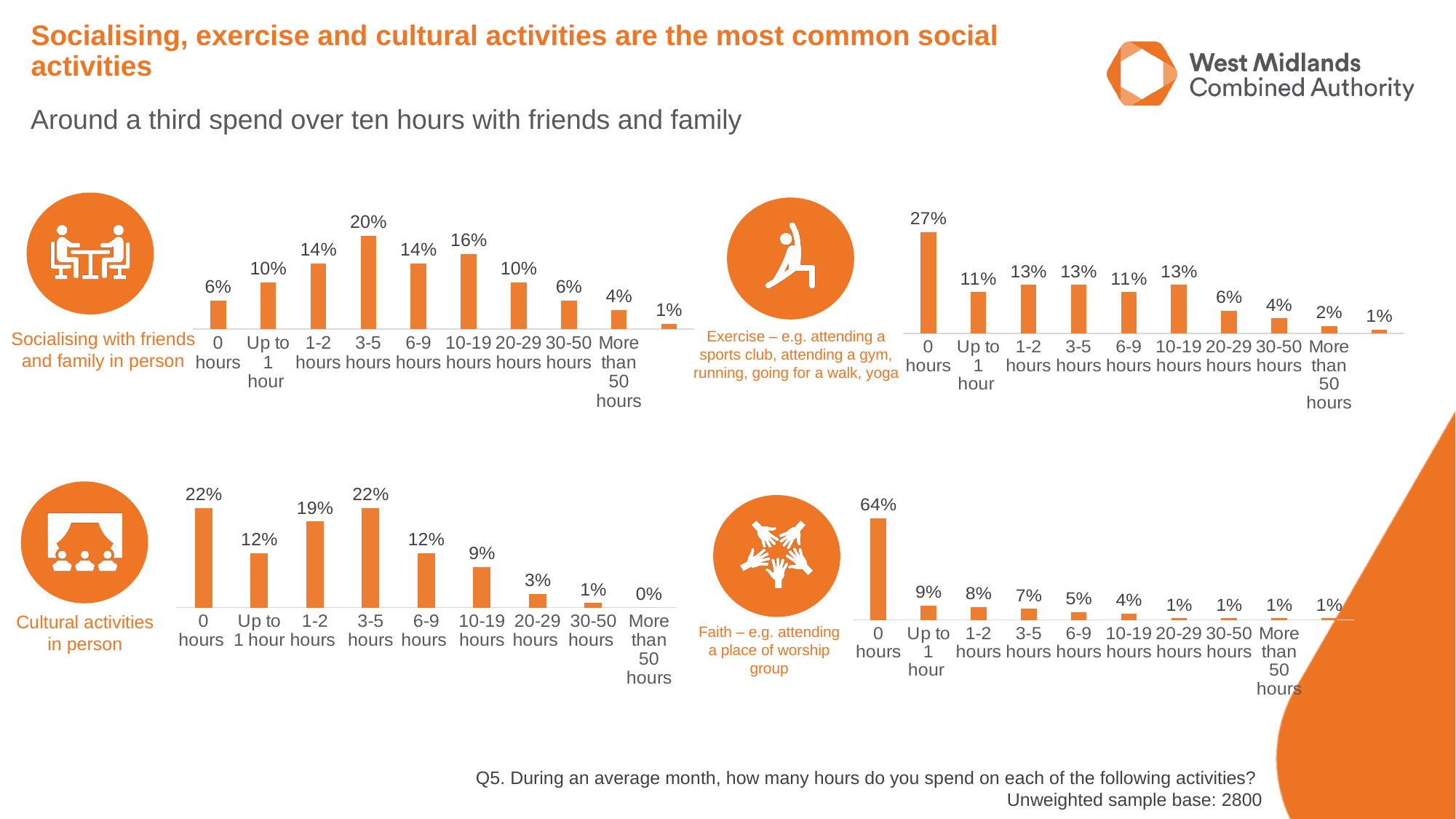
In the 'Faith' chart, do the values rise or fall from 0 hours to 10-19 hours? fall In the 'Exercise' chart, what is the difference between the values for 0 hours and Up to 1 hour? 16 percentage points In the 'Faith' chart, which of 1-2 hours or 6-9 hours has the larger value? 1-2 hours In the 'Socialising with friends and family in person' chart, what is the difference between the values for 10-19 hours and 20-29 hours? 6 percentage points In the 'Cultural activities in person' chart, what percentage is shown for 1-2 hours? 19% What kind of chart is used for the 'Exercise' data? bar chart In the 'Socialising with friends and family in person' chart, which category has the highest value? 3-5 hours In the 'Exercise' chart, what percentage is shown for 0 hours? 27% In the 'Socialising with friends and family in person' chart, what percentage is shown for 3-5 hours? 20% In the 'Cultural activities in person' chart, what percentage is shown for More than 50 hours? 0% In the 'Faith' chart, what percentage is shown for 0 hours? 64% In the 'Cultural activities in person' chart, how many categories are shown on the x axis? 9